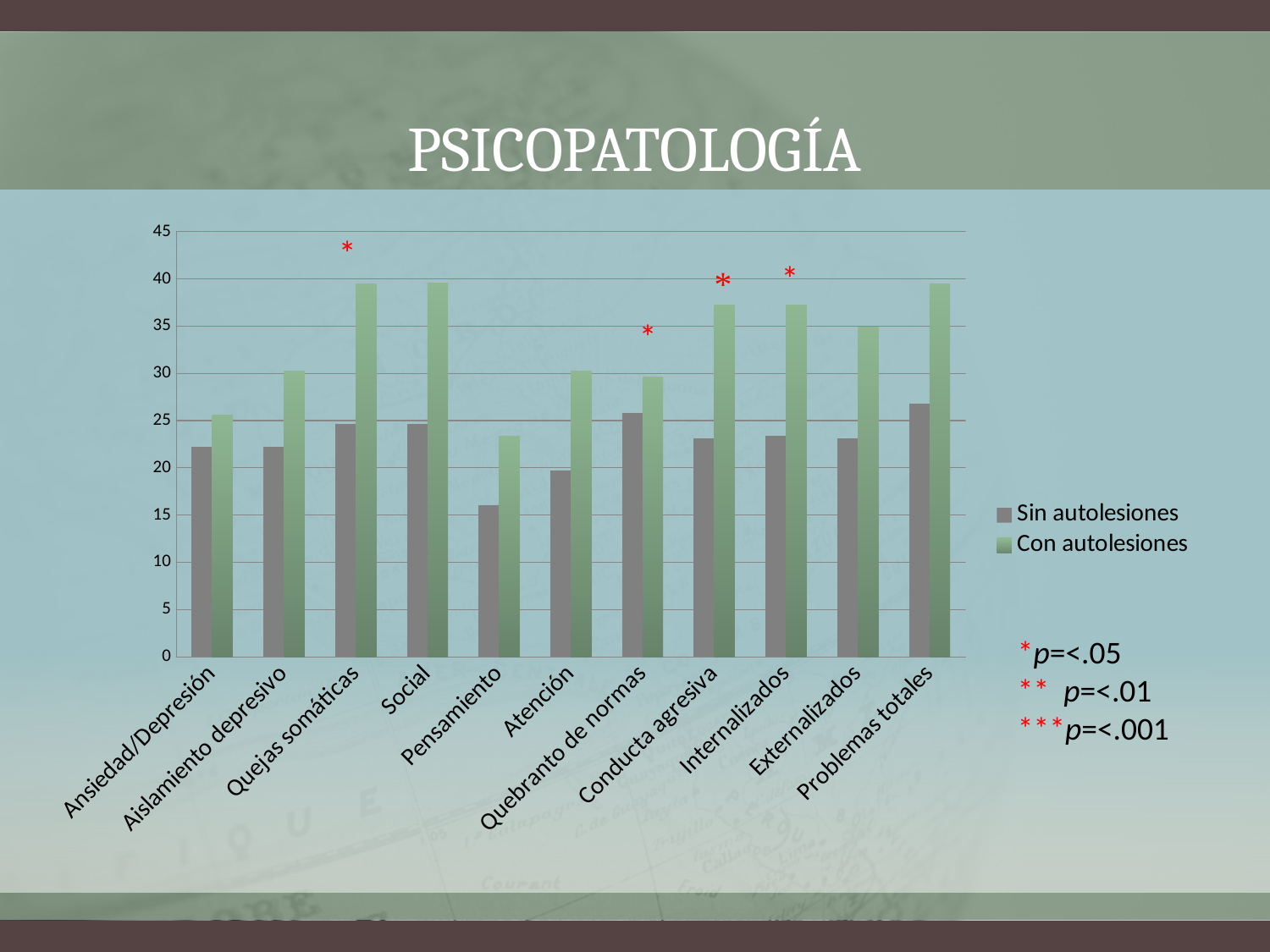
Is the value for Pensamiento in the Con autolesiones series greater or less than 25? less For Social, which series has the larger value, Sin autolesiones or Con autolesiones? Con autolesiones Is the value for Conducta agresiva in the Con autolesiones series greater or less than 35? greater What kind of chart is shown on the slide? Bar chart How many categories are shown on the x axis? 11 Is the value for Quejas somáticas in the Con autolesiones series greater or less than 35? greater What is the title of the slide containing the chart? PSICOPATOLOGÍA Which series is shown in green? Con autolesiones How many series does the legend list? 2 Which category has the lowest value for Con autolesiones? Pensamiento Which category has the lowest value for Sin autolesiones? Pensamiento